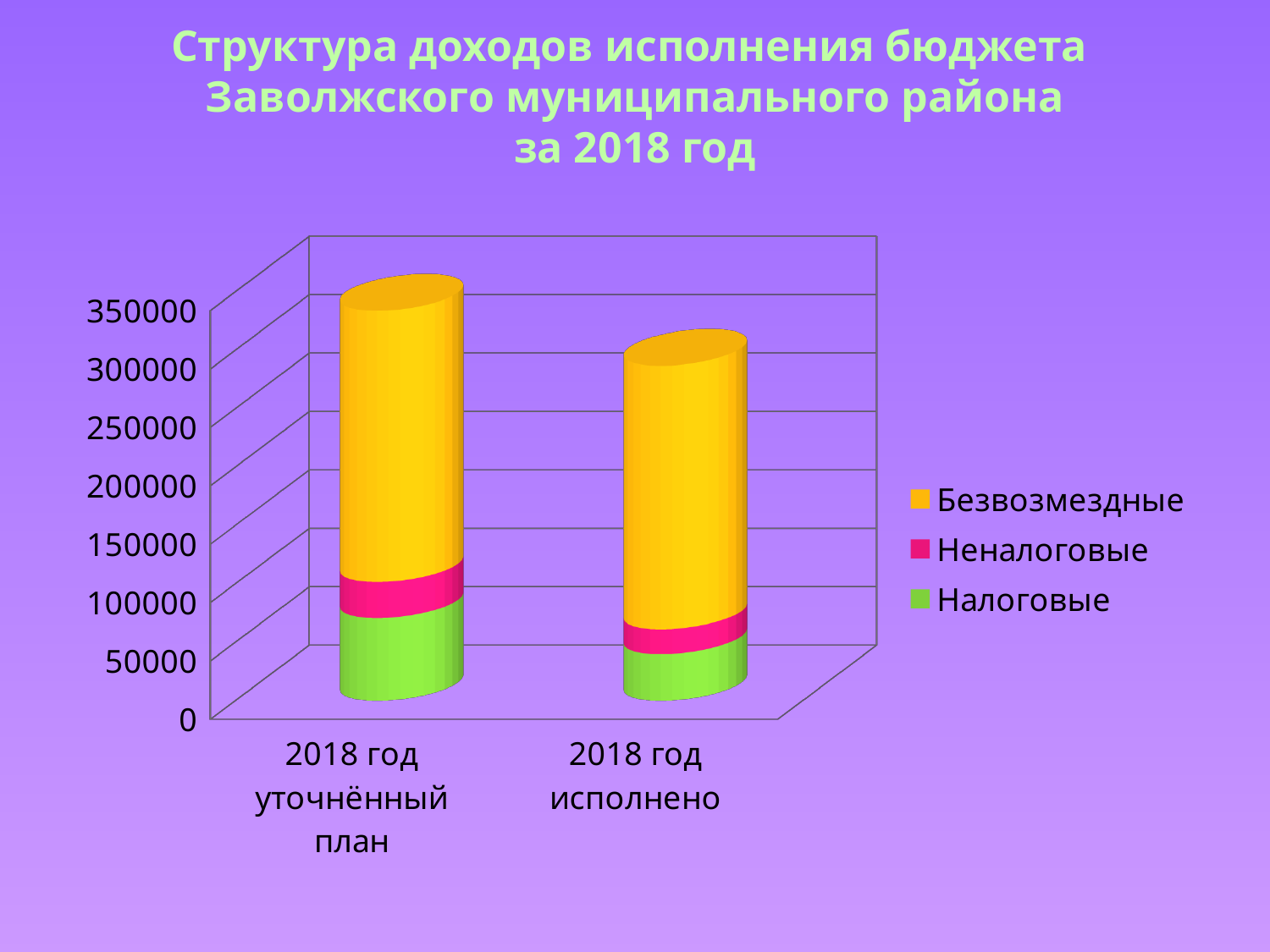
Is the total for "2018 год исполнено" greater or less than 350000? less Which year does the chart title refer to? 2018 Which series makes up the smallest part of the "2018 год исполнено" bar? Неналоговые Which series makes up the largest part of each bar? Безвозмездные Is the total for "2018 год уточнённый план" greater or less than 250000? greater What kind of chart is shown on the slide? bar chart How many series does the legend list? 3 How many categories are shown on the x axis? 2 Which bar is taller overall: "2018 год уточнённый план" or "2018 год исполнено"? 2018 год уточнённый план Is the total for "2018 год исполнено" greater or less than 200000? greater Which colour represents the "Налоговые" series in the legend? green Is the "Налоговые" segment larger in "2018 год уточнённый план" or in "2018 год исполнено"? 2018 год уточнённый план